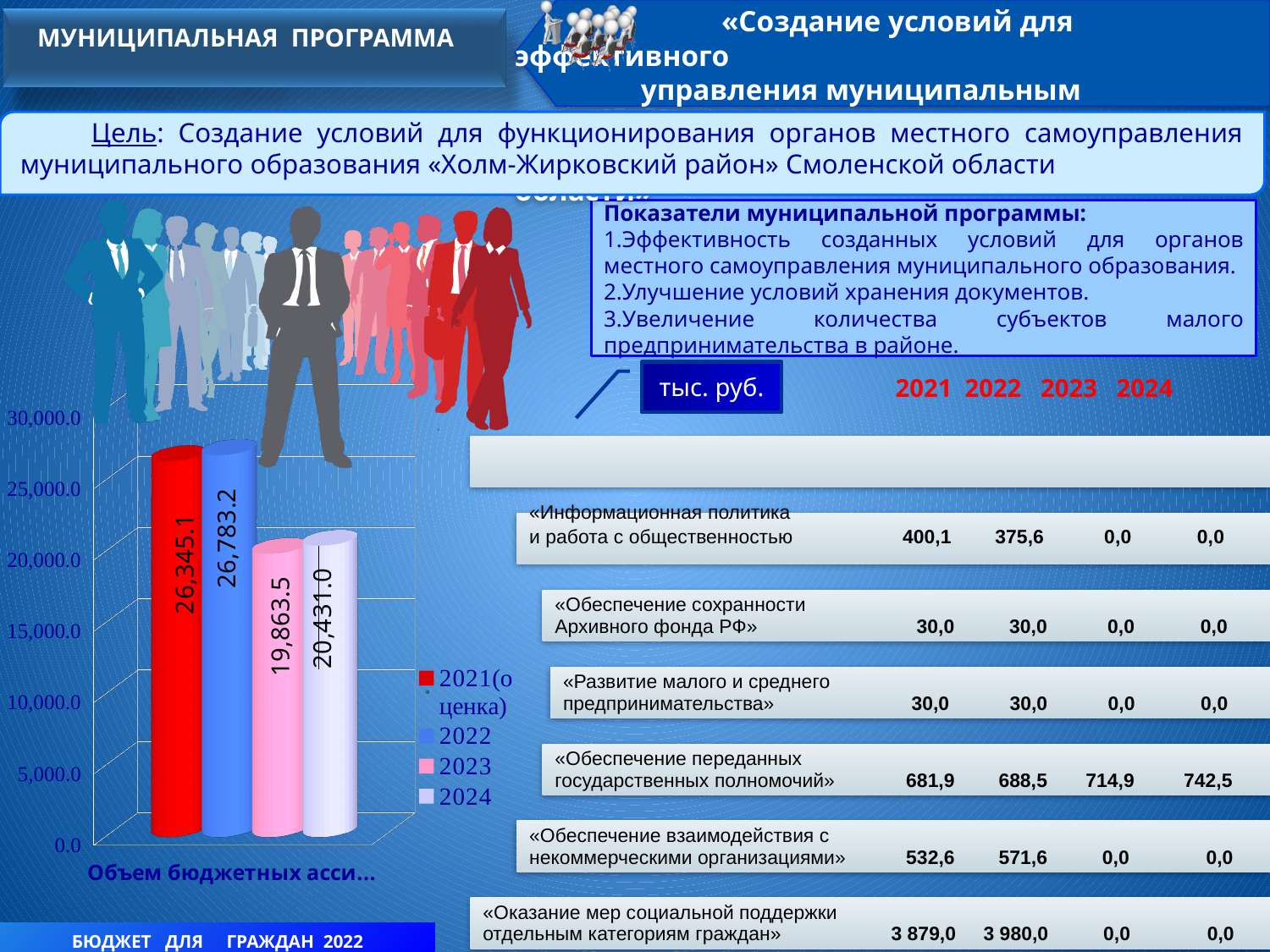
What is the value for 2023 in the bar chart? 19,863.5 Which is larger in the bar chart, the value for 2021 (оценка) or the value for 2023? 2021 (оценка) What is the difference between the values for 2022 and 2021 (оценка) in the bar chart? 438.1 Which year has the highest value in the bar chart? 2022 What is the value for 2024 in the bar chart? 20,431.0 Is the value for 2023 in the bar chart greater or less than 20,000.0? less What is the difference between the values for 2024 and 2023 in the bar chart? 567.5 What type of chart is shown on the slide? bar chart What is the value for 2022 in the bar chart? 26,783.2 How many series does the legend of the bar chart list? 4 Which year has the lowest value in the bar chart? 2023 What is the value for 2021 (оценка) in the bar chart? 26,345.1